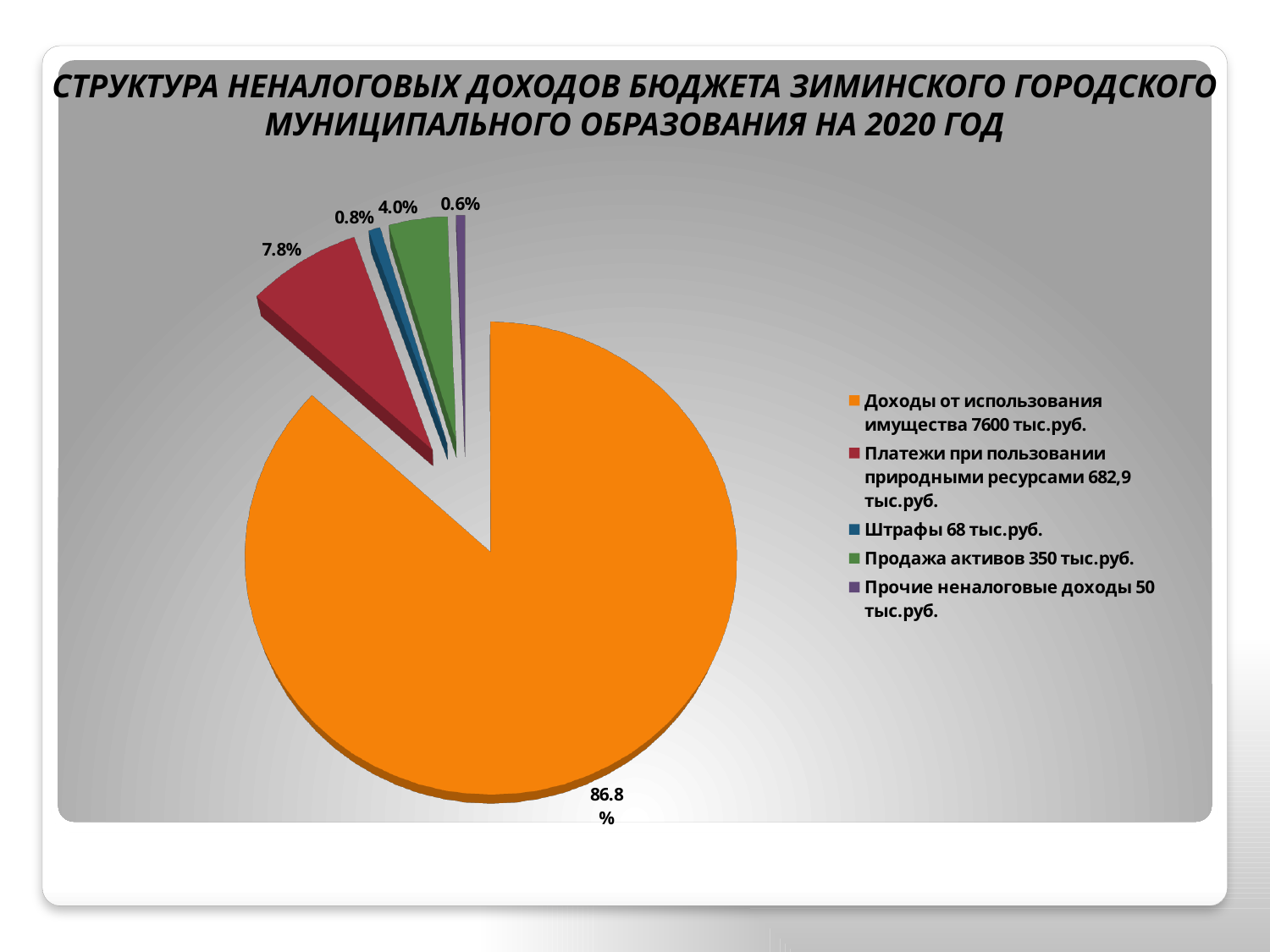
What share of the pie is labelled for 'Прочие неналоговые доходы'? 0.6% How many slices does the pie chart have? 5 Which colour represents 'Штрафы 68 тыс.руб.' in the legend? Blue Which category has the smallest share of the pie? Прочие неналоговые доходы What share of the pie is labelled for 'Платежи при пользовании природными ресурсами'? 7.8% What is the difference in percentage points between the shares for 'Платежи при пользовании природными ресурсами' and 'Продажа активов'? 3.8 Which category has the largest share of the pie? Доходы от использования имущества How many entries does the legend list? 5 What share of the pie is labelled for 'Штрафы'? 0.8% What type of chart is shown on the slide? Pie chart